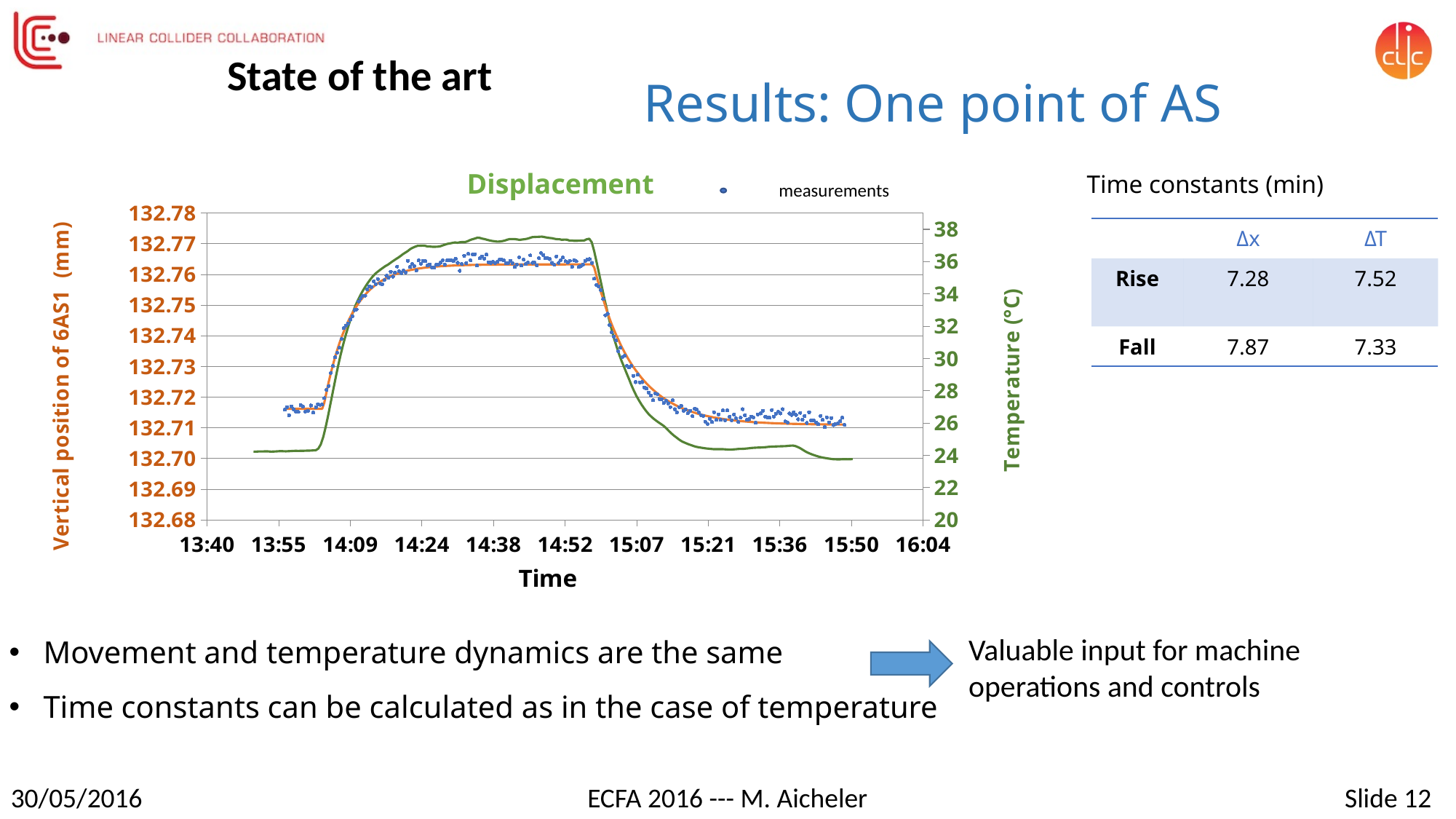
Does the temperature rise or fall between 14:52 and 15:07? fall How many series does the chart legend list? 1 Does the vertical position of 6AS1 rise or fall between 14:09 and 14:24? rise How many time labels are shown on the x axis of the chart? 11 Is the temperature at 14:38 greater or less than 36 °C? greater Is the vertical position of 6AS1 at 15:36 greater or less than 132.72 mm? less What is the label of the right-hand vertical axis of the chart? Temperature (°C) Is the vertical position of 6AS1 at 14:38 greater or less than 132.75 mm? greater Is the vertical position of 6AS1 higher at 14:38 or at 15:21? 14:38 What is the title of the chart? Displacement What kind of chart is shown on the slide? line chart